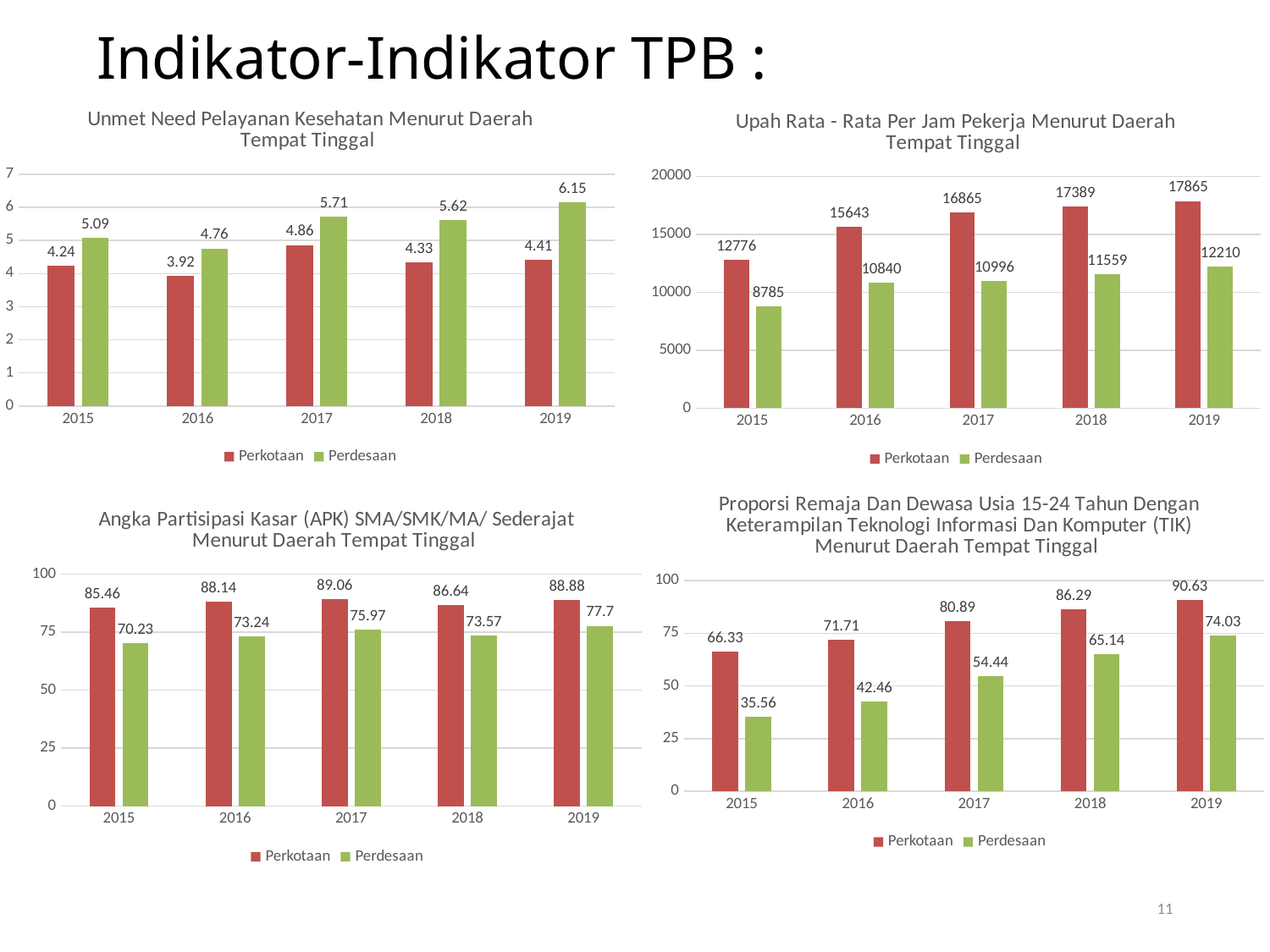
In the top-left chart (Unmet Need Pelayanan Kesehatan), what is the Perdesaan value for 2019? 6.15 In the top-left chart (Unmet Need Pelayanan Kesehatan), which year has the lowest Perkotaan value? 2016 In the top-right chart (Upah Rata-Rata Per Jam Pekerja), what is the Perkotaan value for 2016? 15643 What kind of chart is the top-left chart (Unmet Need Pelayanan Kesehatan)? bar chart In the bottom-right chart (Proporsi Remaja Dan Dewasa dengan Keterampilan TIK), what is the Perdesaan value for 2015? 35.56 In the bottom-left chart (Angka Partisipasi Kasar SMA/SMK/MA), what is the Perdesaan value for 2017? 75.97 In the bottom-left chart (Angka Partisipasi Kasar SMA/SMK/MA), which year has the highest Perkotaan value? 2017 How many series does the legend of the bottom-right chart (Proporsi Remaja Dan Dewasa dengan Keterampilan TIK) list? 2 In the top-right chart (Upah Rata-Rata Per Jam Pekerja), does the Perkotaan value rise or fall from 2015 to 2019? rise In the top-right chart (Upah Rata-Rata Per Jam Pekerja), which year has the highest Perdesaan value? 2019 In the top-left chart (Unmet Need Pelayanan Kesehatan), what is the difference between the Perdesaan and Perkotaan values in 2017? 0.85 In the bottom-right chart (Proporsi Remaja Dan Dewasa dengan Keterampilan TIK), what is the difference between the Perkotaan and Perdesaan values in 2019? 16.6